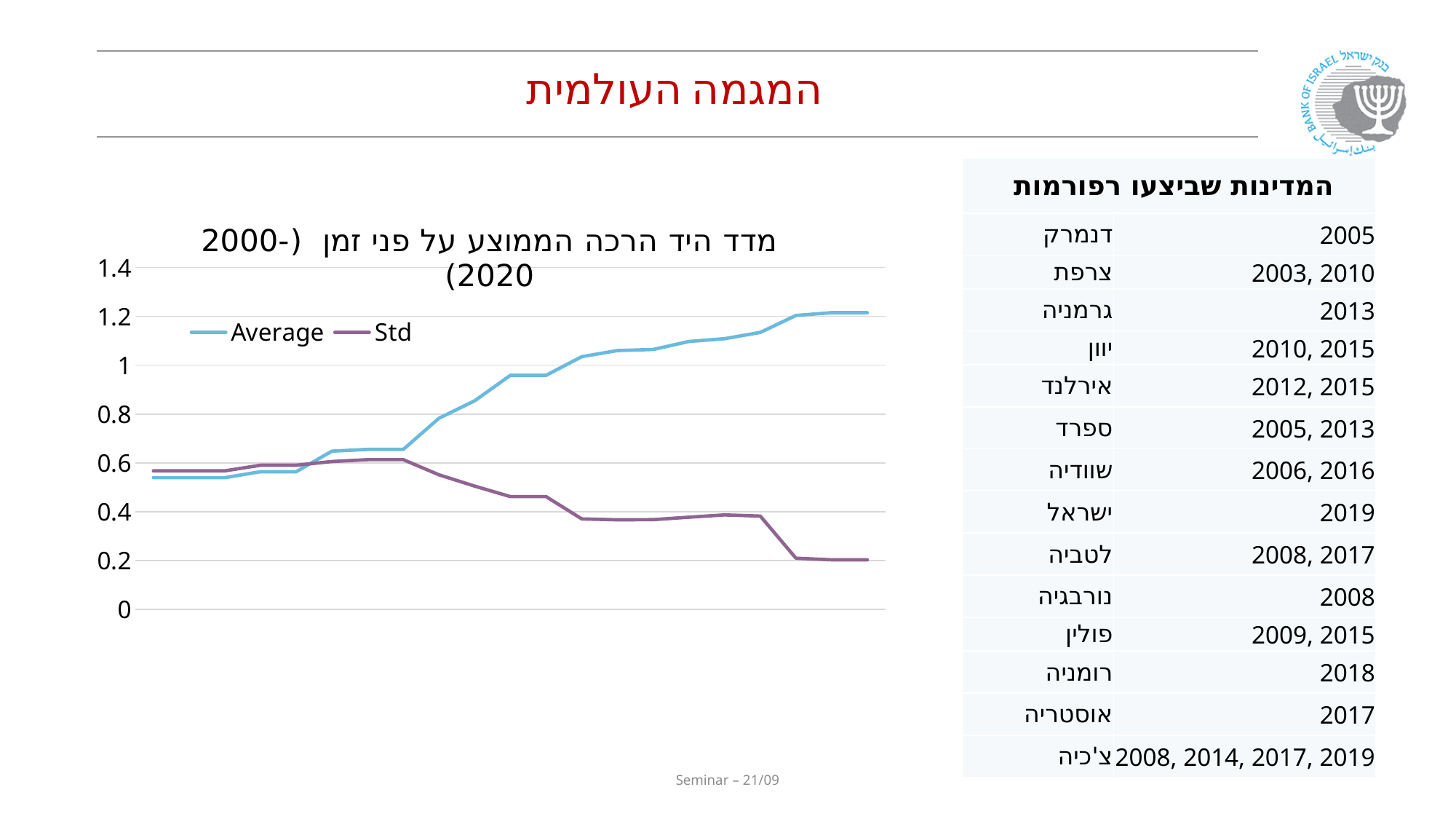
What kind of chart is shown on the slide? line chart How many series does the chart's legend list? 2 Is the first value of the Std series greater or less than 0.4? greater Does the Std series rise or fall along the x axis overall? fall What are the names of the two series in the chart's legend? Average and Std Is the final value of the Std series greater or less than 0.4? less At the right end of the chart, which series has the higher value, Average or Std? Average What is the highest tick value shown on the chart's vertical axis? 1.4 Is the final value of the Average series greater or less than 1? greater Does the Average series rise or fall along the x axis? rise Which series reaches the highest value anywhere on the chart? Average